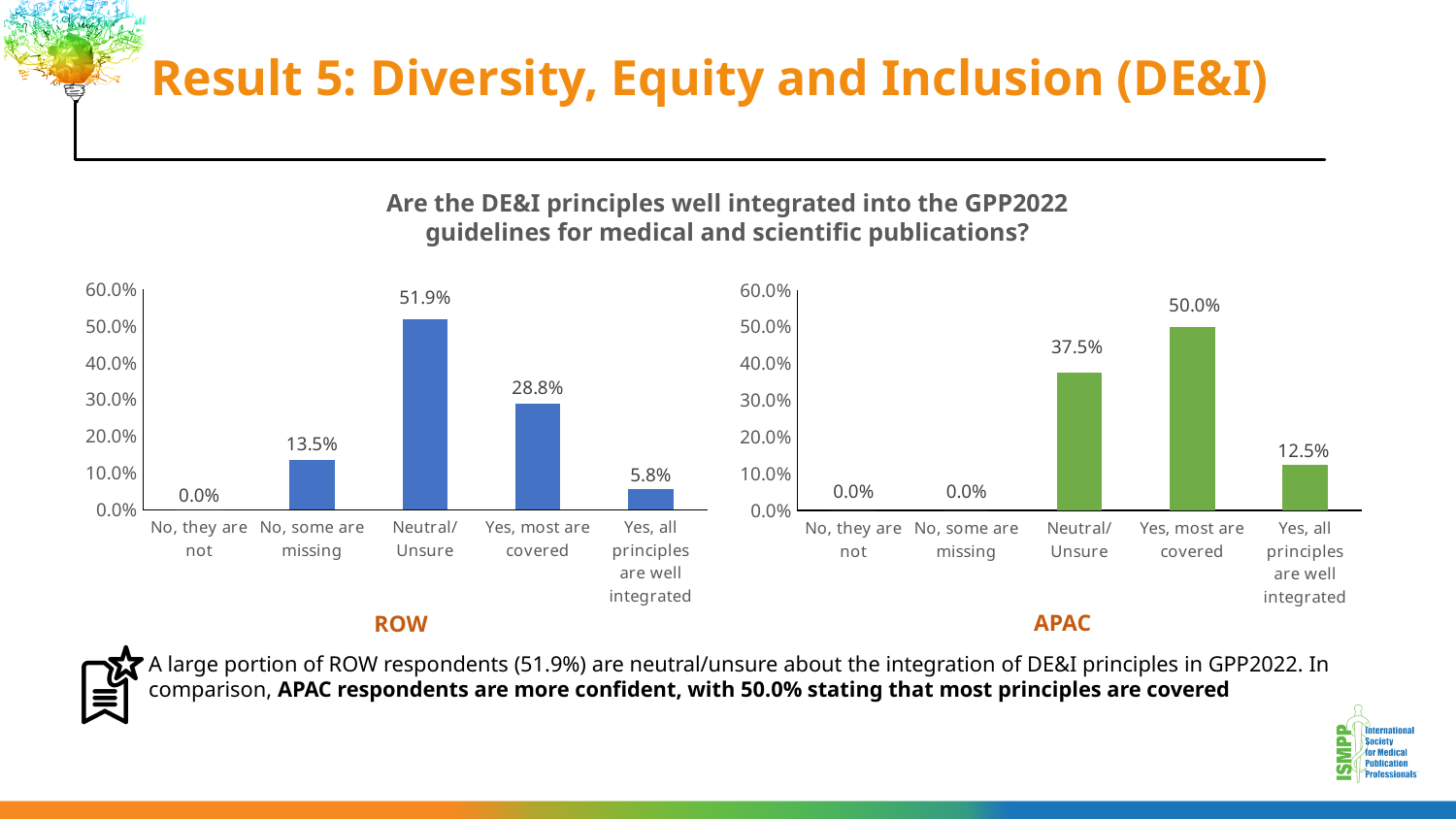
Which is larger: the ROW value for "No, some are missing" or the APAC value for "Yes, all principles are well integrated"? ROW "No, some are missing" In the ROW chart, which category has the highest value? Neutral/Unsure In the APAC chart, which category has the highest value? Yes, most are covered In the APAC chart, what is the difference between "Yes, most are covered" and "Yes, all principles are well integrated"? 37.5% How many categories are shown on the x axis of the APAC chart? 5 What colour are the bars in the APAC chart? Green What type of chart is the ROW chart? Bar chart In the APAC chart, what is the value for "Yes, most are covered"? 50.0% In the ROW chart, what is the value for "Neutral/Unsure"? 51.9% In the ROW chart, what is the difference between "Neutral/Unsure" and "Yes, most are covered"? 23.1% In the ROW chart, what is the value for "Yes, all principles are well integrated"? 5.8% In the APAC chart, what is the value for "Neutral/Unsure"? 37.5%